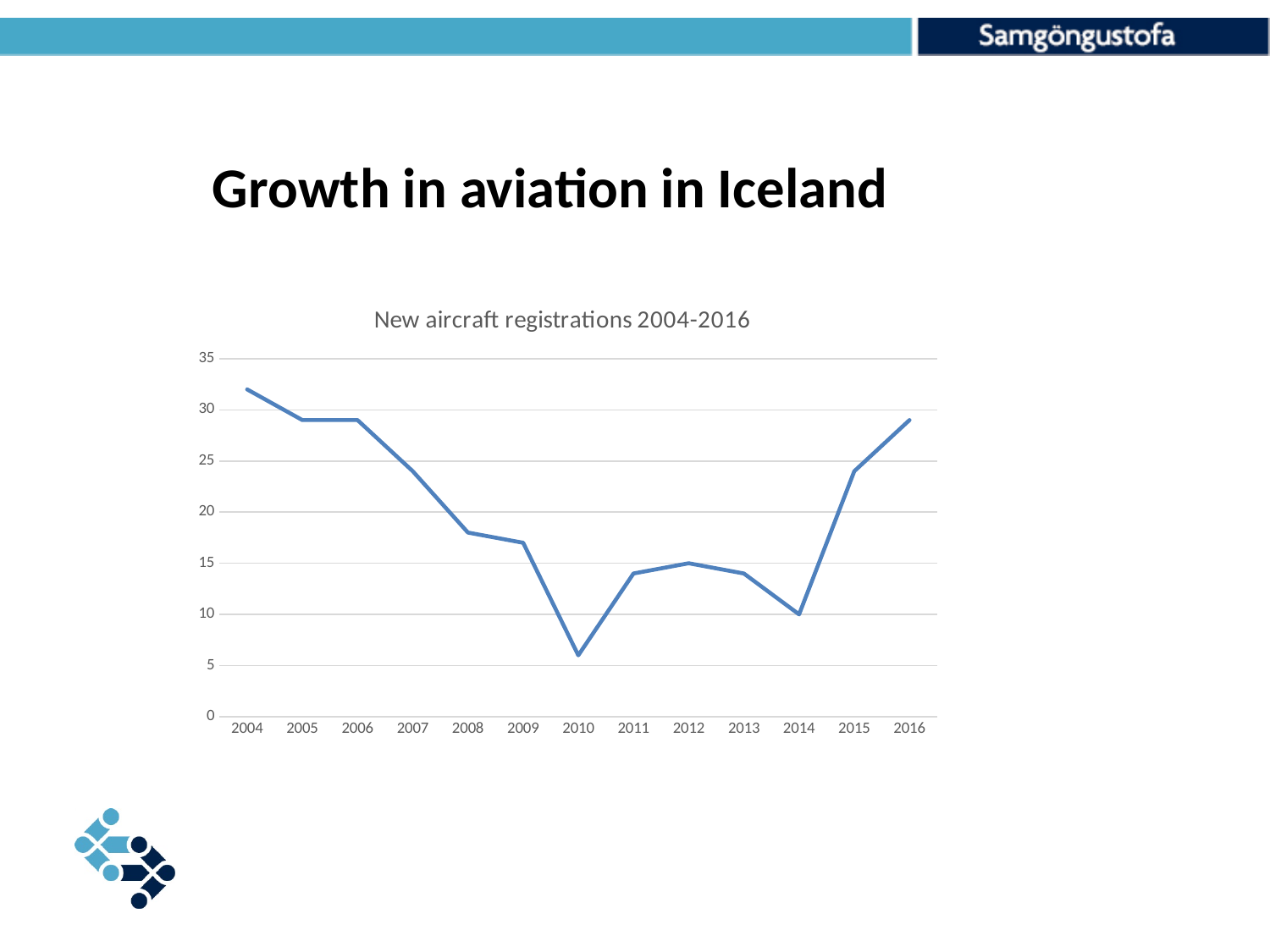
Is the value for 2004 greater or less than 30? greater Which year has the lowest number of new aircraft registrations? 2010 Is the value for 2015 greater or less than 20? greater What is the title of the chart? New aircraft registrations 2004-2016 Which year has more new aircraft registrations, 2007 or 2011? 2007 Is the value for 2010 greater or less than 10? less Which year has the highest number of new aircraft registrations? 2004 Which year has more new aircraft registrations, 2016 or 2014? 2016 What kind of chart is shown on the slide? line chart Do the values rise or fall from 2004 to 2010? fall How many years are plotted on the x axis of the chart? 13